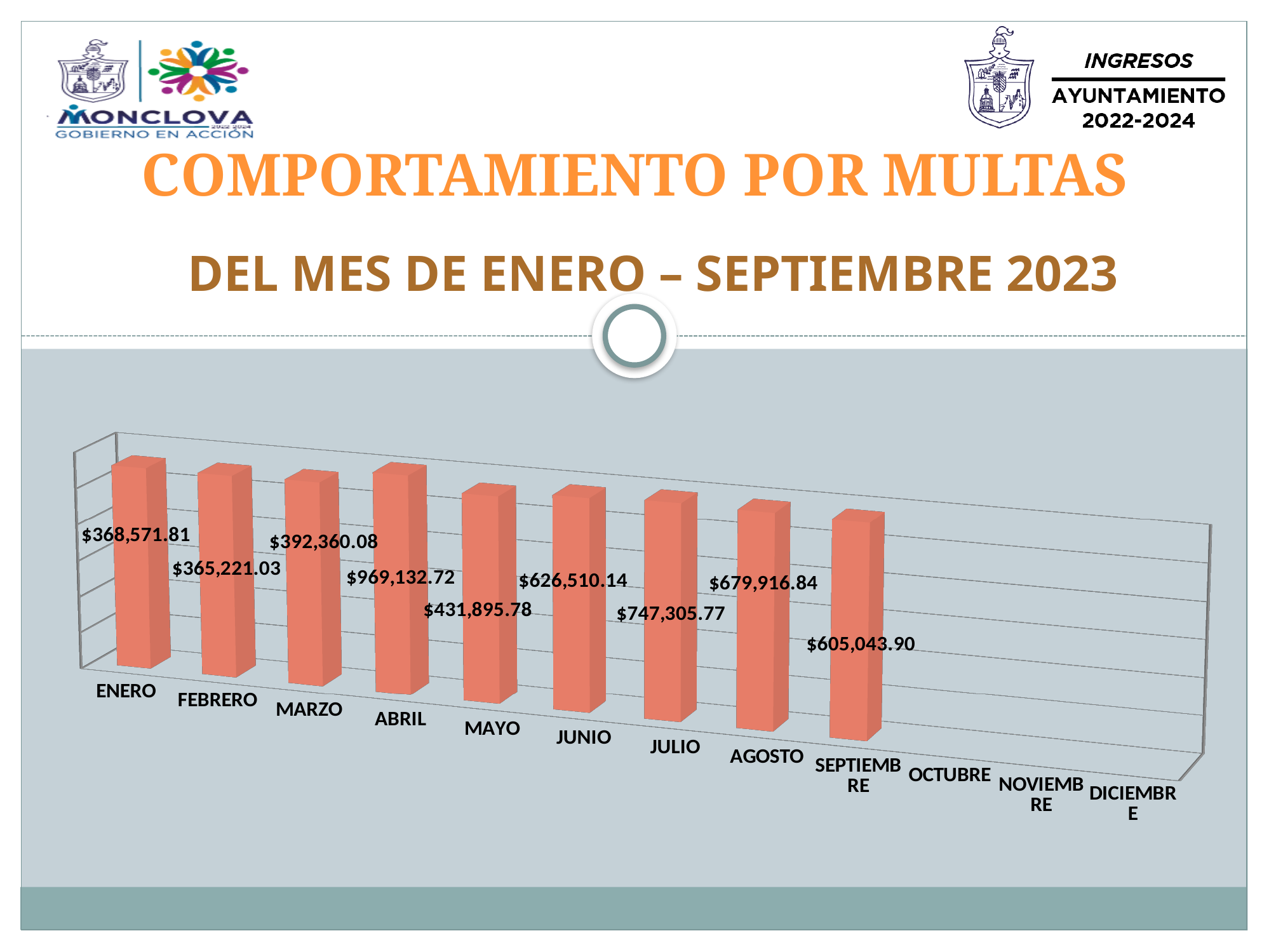
What is the value for JULIO? $747,305.77 Which month has the highest value? ABRIL Which is larger, the value for JULIO or the value for AGOSTO? JULIO What is the difference between the values for ABRIL and MARZO? $576,772.64 Do the values rise or fall from MAYO to JULIO? rise What is the value for ABRIL? $969,132.72 What is the value for ENERO? $368,571.81 How many bars with data labels are shown in the chart? 9 What is the value for SEPTIEMBRE? $605,043.90 What kind of chart is shown on the slide? bar chart Which month has the lowest value? FEBRERO What is the difference between the values for JULIO and JUNIO? $120,795.63